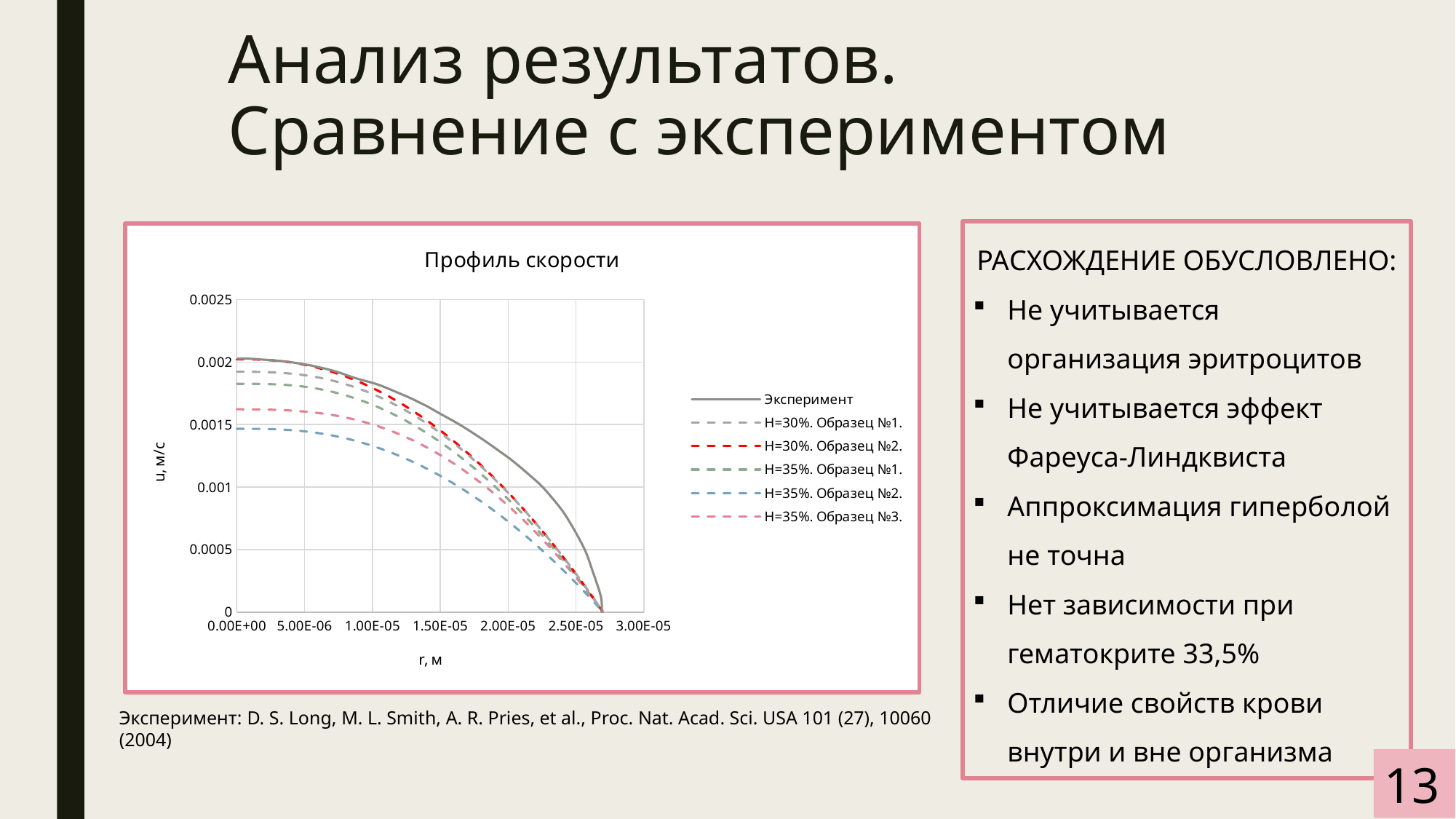
Which series has the lowest value at r = 0.00E+00? H=35%. Образец №2. Do the values of the Эксперимент series rise or fall as r increases along the x axis? fall Which series in the chart is drawn as a solid line rather than a dashed line? Эксперимент Is the value for H=35%. Образец №2. at r = 0.00E+00 greater or less than 0.0015? less Is the value for H=35%. Образец №2. at r = 2.00E-05 greater or less than 0.001? less What is the title of the chart? Профиль скорости How many series does the legend of the chart list? 6 At r = 0.00E+00, which is larger: the value for Эксперимент or the value for H=35%. Образец №2.? Эксперимент Is the value for H=35%. Образец №1. at r = 0.00E+00 greater or less than 0.0015? greater What kind of chart is shown on the slide? line chart